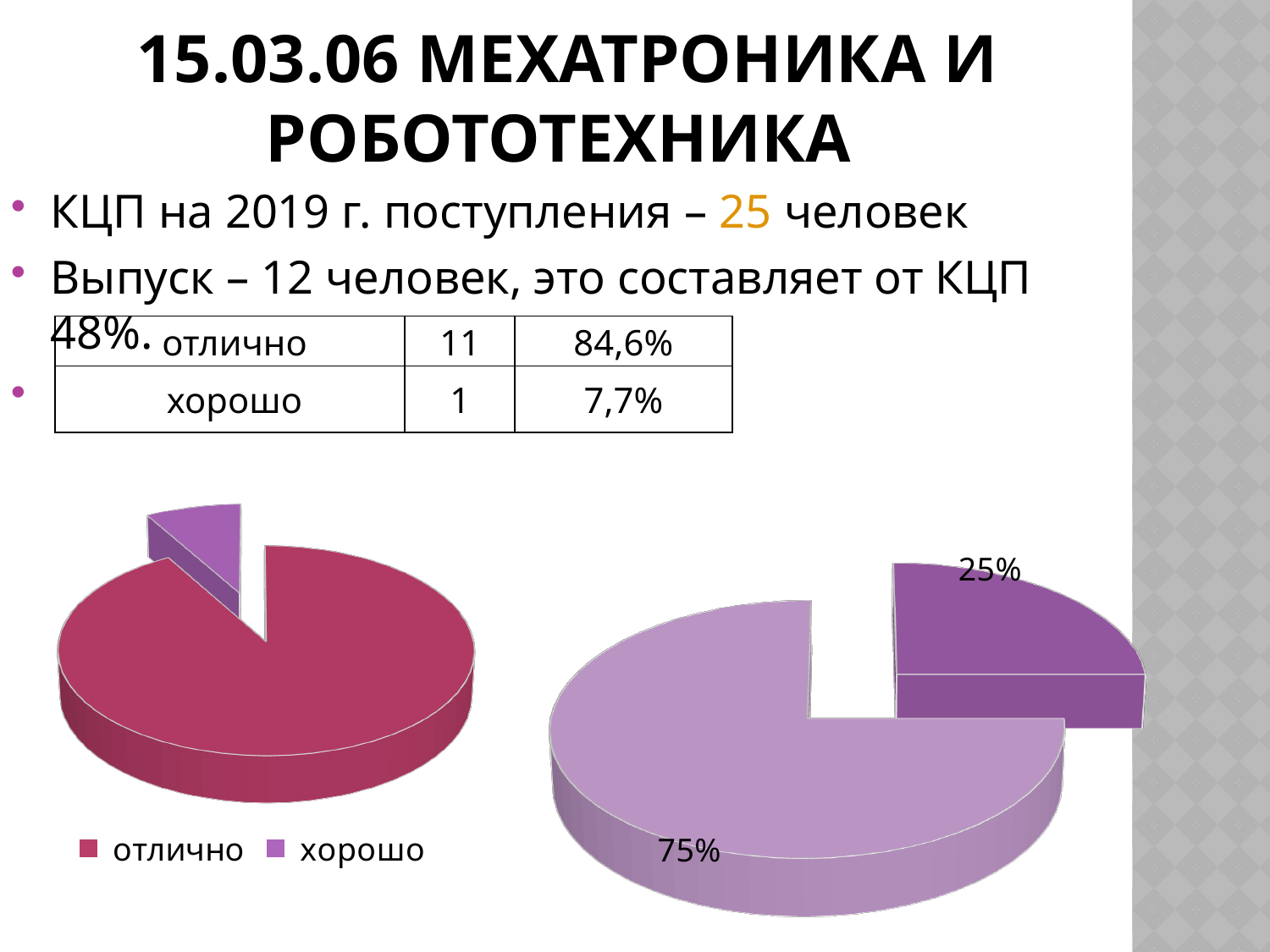
In the right chart, what percentage is shown on the dark purple slice? 25% In the left chart, what colour is the slice for отлично? red (crimson) In the left chart, which category has the smallest slice? хорошо In the left chart, how many entries does the legend list? 2 What kind of chart is the chart on the right of the slide? pie chart In the right chart, what is the share of the smallest slice? 25% In the left chart, which category has the larger slice, отлично or хорошо? отлично In the right chart, what is the difference in percentage points between the two slices? 50 In the right chart, what percentage is shown on the light purple slice? 75% What kind of chart is the chart on the left of the slide? pie chart In the right chart, what is the share of the largest slice? 75% How many slices does the right chart have? 2